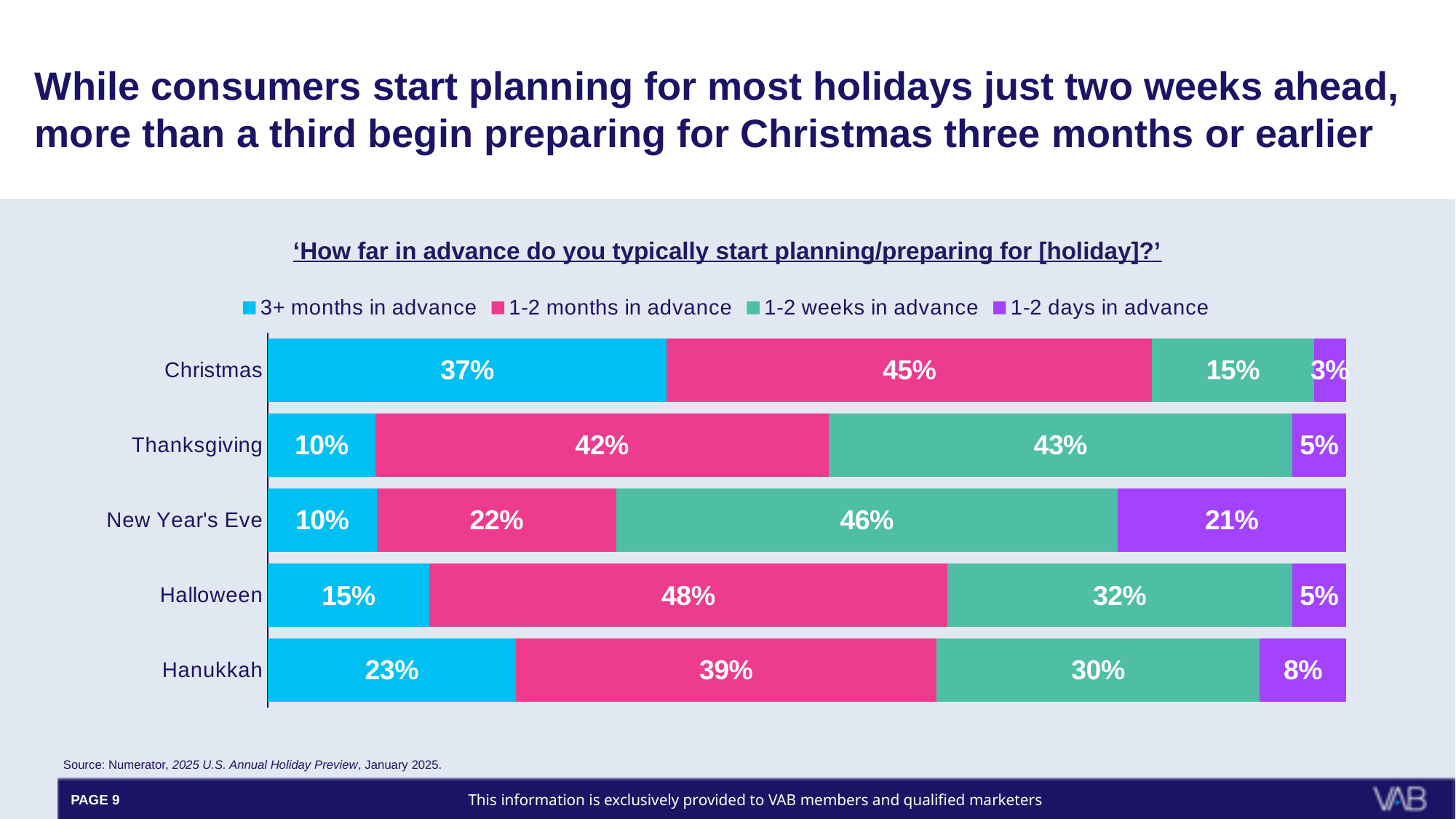
What is the combined share of consumers who plan for Hanukkah 3+ months or 1-2 months in advance? 62% Which is larger: the 1-2 months in advance share for Hanukkah or for Thanksgiving? Thanksgiving Which holiday has the lowest share of consumers planning 1-2 days in advance? Christmas What percentage of consumers start planning for Christmas 3+ months in advance? 37% How many holidays are shown in the chart? 5 What kind of chart is shown on the slide? Stacked bar chart What percentage of consumers start planning for New Year's Eve 1-2 days in advance? 21% Which holiday has the highest share of consumers planning 3+ months in advance? Christmas Which legend entry is shown in purple? 1-2 days in advance What percentage of consumers start planning for Halloween 1-2 months in advance? 48% How many series does the legend list? 4 What is the difference between the 1-2 weeks in advance share for Thanksgiving and for Christmas? 28 percentage points